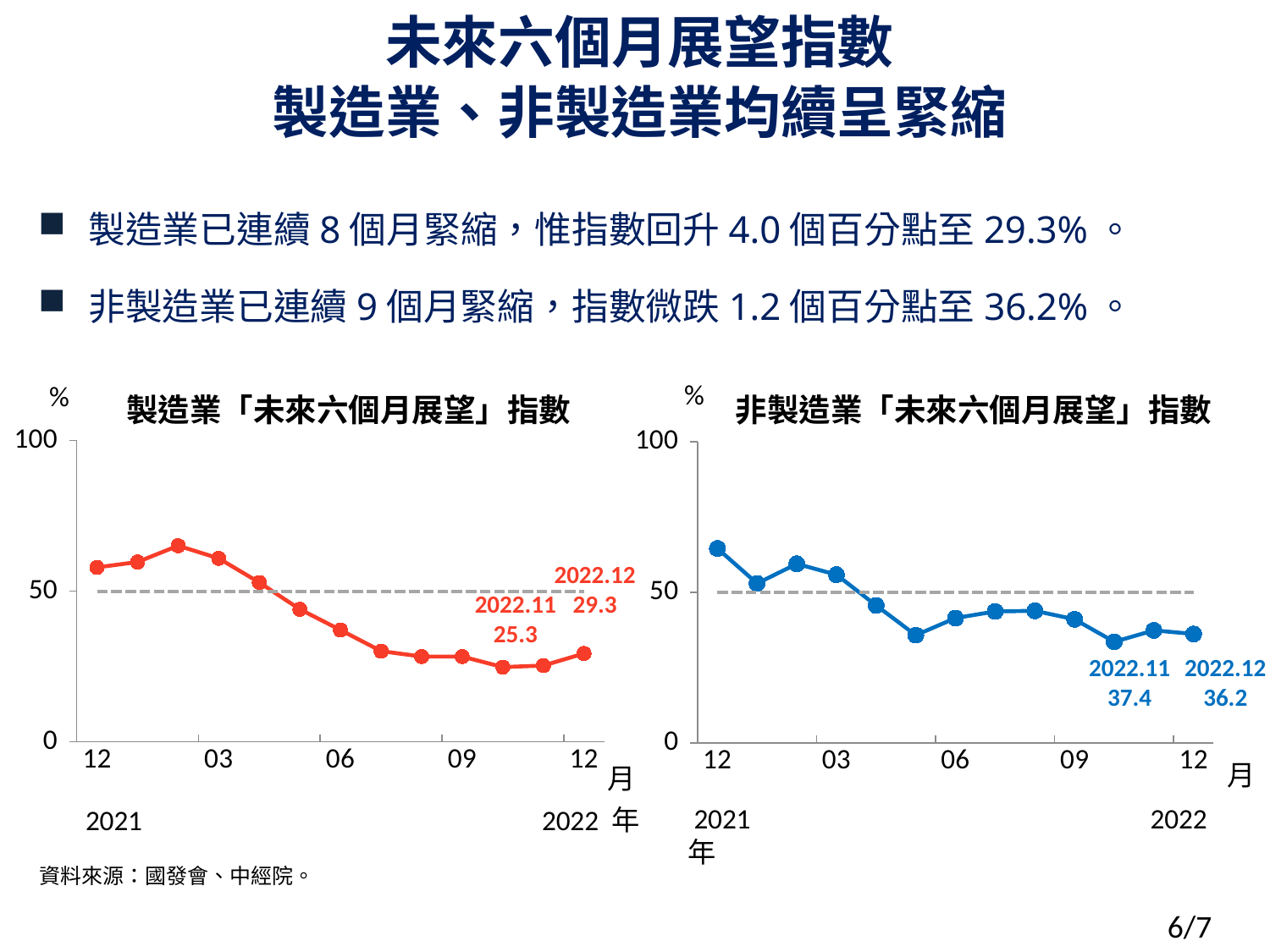
In the 非製造業「未來六個月展望」指數 chart on the right, is the value for 06 of 2022 greater or less than 50? less In the 製造業「未來六個月展望」指數 chart on the left, what is the value for 2022.11? 25.3 How many data points are plotted in the 非製造業「未來六個月展望」指數 chart on the right? 13 In the 非製造業「未來六個月展望」指數 chart on the right, what is the value for 2022.12? 36.2 In the 非製造業「未來六個月展望」指數 chart on the right, what is the value for 2022.11? 37.4 What type of chart is the 製造業「未來六個月展望」指數 chart on the left? Line chart In the 製造業「未來六個月展望」指數 chart on the left, what is the value for 2022.12? 29.3 Comparing the 2022.12 values, which chart shows the higher value: 製造業 (left) or 非製造業 (right)? 非製造業 In the 製造業「未來六個月展望」指數 chart on the left, is the value for 12 of 2021 greater or less than 50? greater In the 非製造業「未來六個月展望」指數 chart on the right, what is the difference between the 2022.11 and 2022.12 values? 1.2 In the 製造業「未來六個月展望」指數 chart on the left, by how much did the value change from 2022.11 to 2022.12? 4.0 In the 製造業「未來六個月展望」指數 chart on the left, which month has the highest value? 02 of 2022 (February 2022)